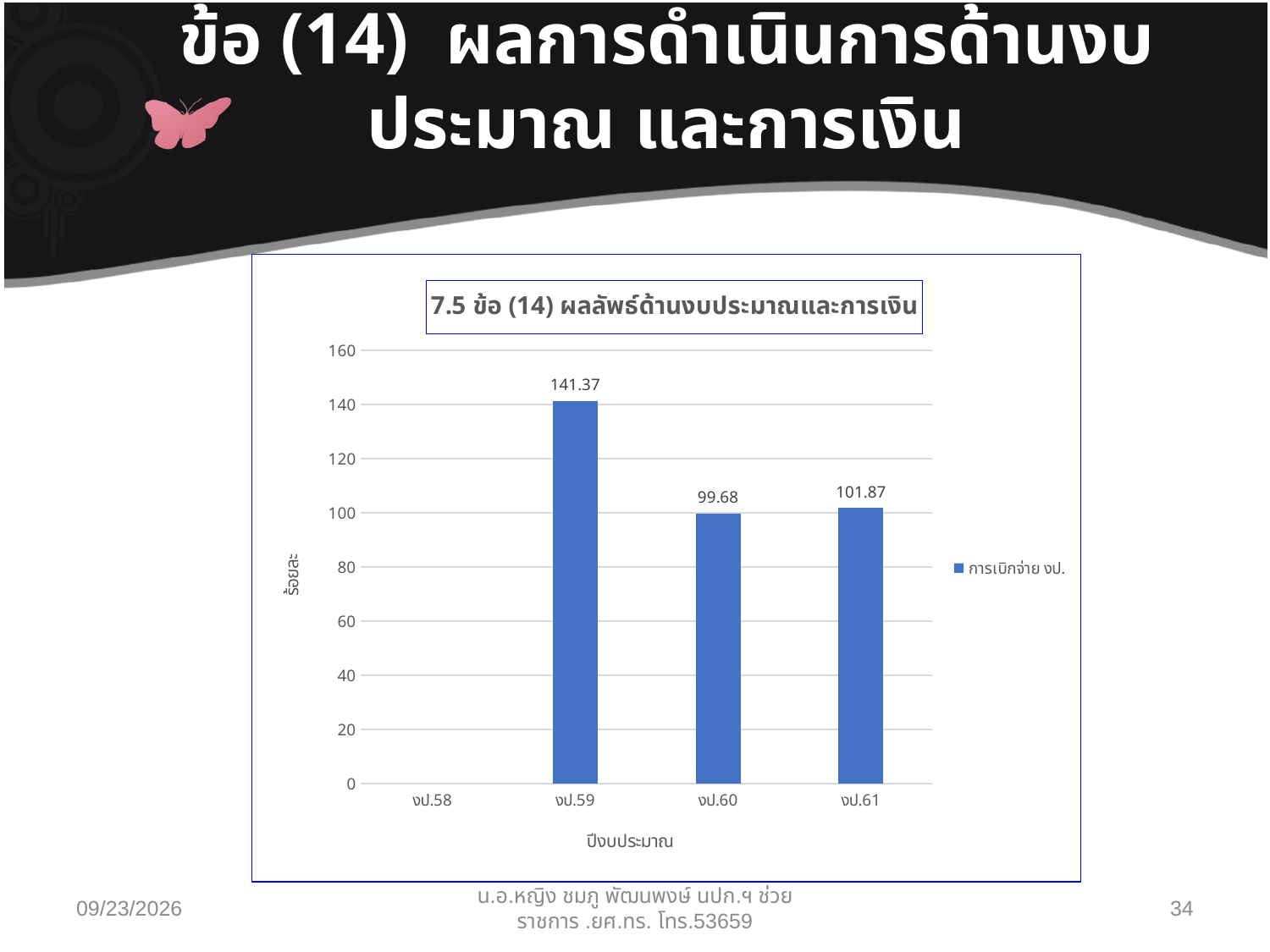
What kind of chart is shown? bar chart How many categories are shown on the x axis? 4 What is the value for งป.60? 99.68 Is the value for งป.59 greater or less than 140? greater What is the value for งป.59? 141.37 Which is larger, the value for งป.60 or the value for งป.61? งป.61 What is the difference between the values for งป.59 and งป.61? 39.50 What is the value for งป.61? 101.87 What is the difference between the values for งป.61 and งป.60? 2.19 Which of the plotted bars has the lowest value? งป.60 Which fiscal year has the highest value? งป.59 What is the legend entry for the series? การเบิกจ่าย งป.